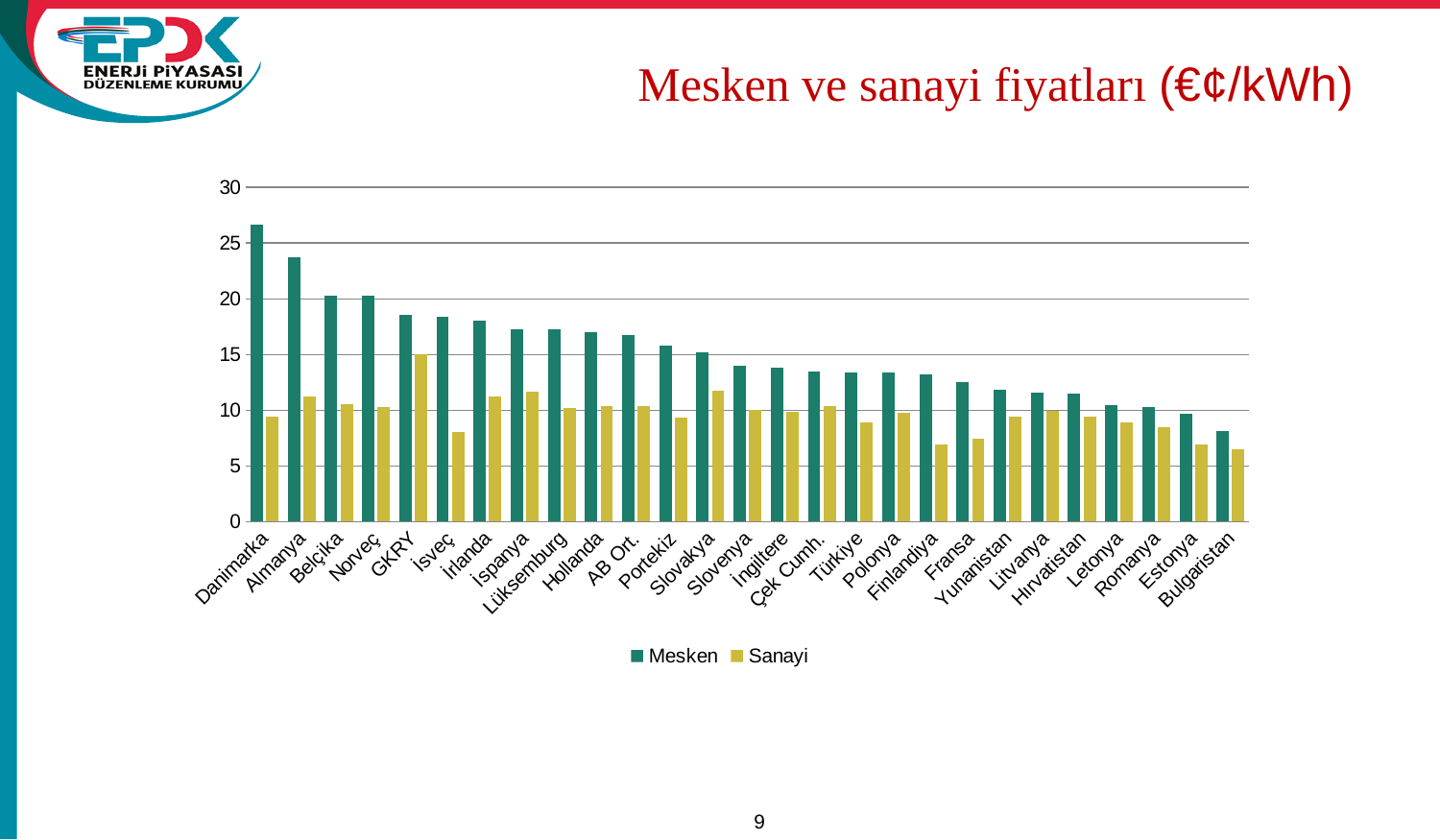
What unit is given in the chart title? €¢/kWh Is the Mesken value for Bulgaristan greater or less than 10? less Which category has the lowest Mesken value? Bulgaristan How many series does the legend list? 2 Which category has the highest Sanayi value? GKRY Is the Mesken value for Danimarka greater or less than 25? greater How many countries/categories are shown on the x axis? 27 Which is larger, the Sanayi value for GKRY or the Sanayi value for İsveç? GKRY What kind of chart is shown on the slide? bar chart Which category has the highest Mesken value? Danimarka Do the Mesken values generally rise or fall from left to right along the x axis? fall Is the Sanayi value for Türkiye greater or less than 10? less